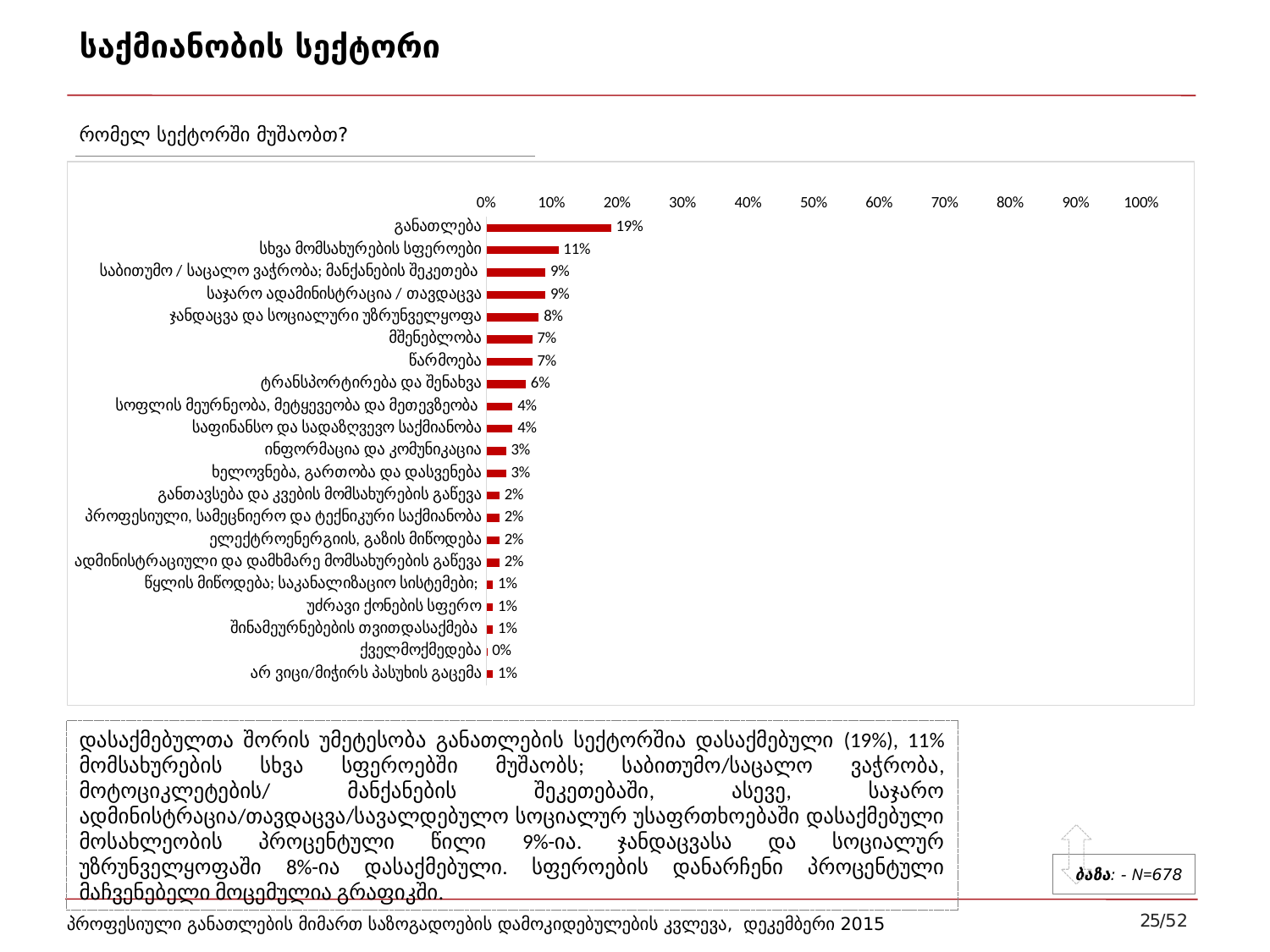
What is the difference between the values for განათლება and სხვა მომსახურების სფეროები? 8% What is the maximum value shown on the percentage axis of the chart? 100% What percentage is shown for ტრანსპორტირება და შენახვა? 6% Which category has the highest value in the chart? განათლება Which category has the lowest value in the chart? ქველმოქმედება What percentage is shown for ჯანდაცვა და სოციალური უზრუნველყოფა? 8% What kind of chart is shown on the slide? bar chart What percentage is shown for სხვა მომსახურების სფეროები? 11% Is the value for განათლება greater or less than 10%? greater How many categories are shown in the chart? 21 What percentage is shown for განათლება? 19% Which is larger, the value for მშენებლობა or the value for ინფორმაცია და კომუნიკაცია? მშენებლობა